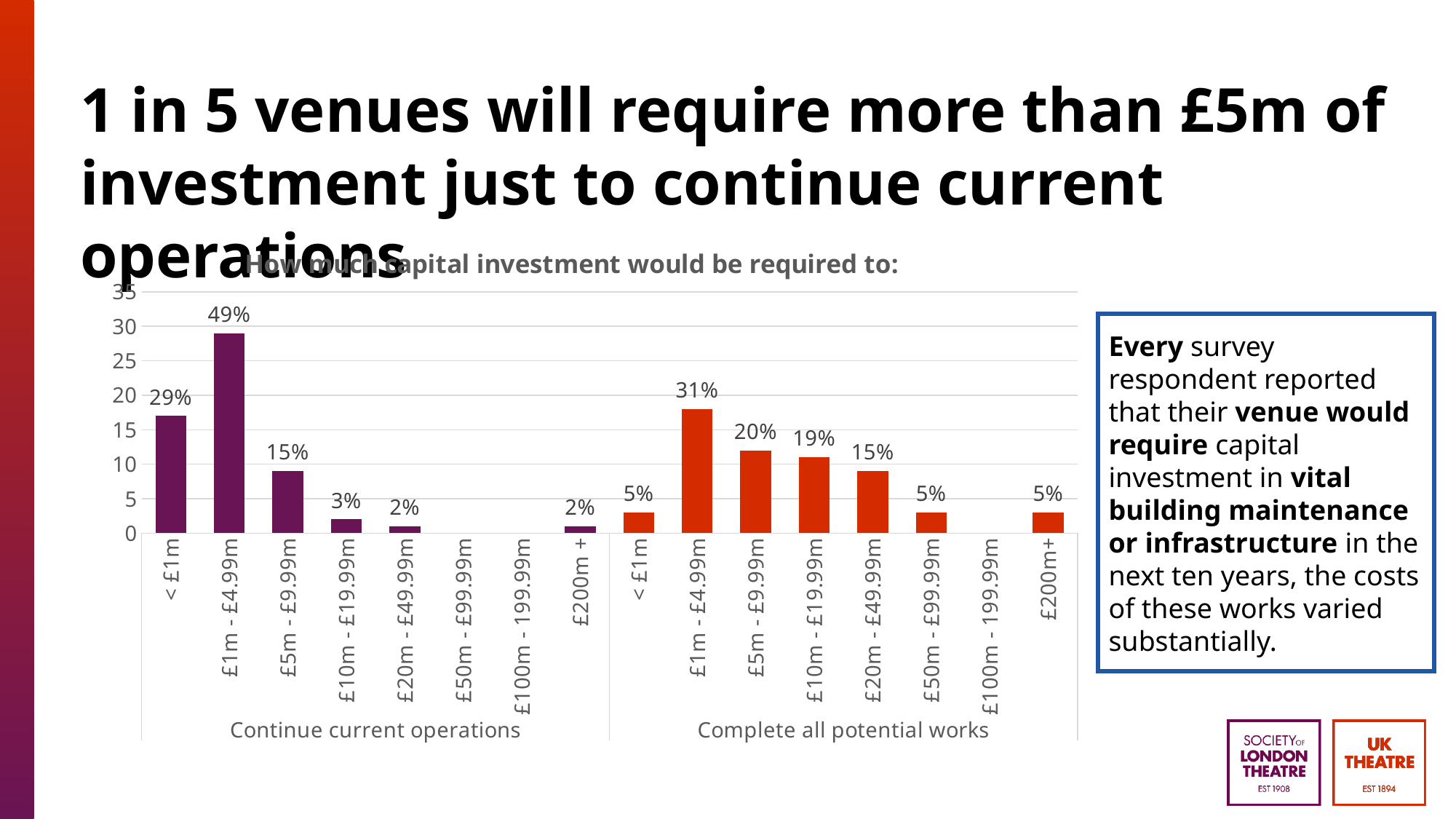
What percentage label is shown for the £200m+ bar under Complete all potential works? 5% What percentage label is shown for the £5m - £9.99m bar under Complete all potential works? 20% Which investment band has the highest bar under Continue current operations? £1m - £4.99m What kind of chart is shown on the slide? Bar chart How many investment band categories are listed on the x axis for each group? 8 What percentage label is shown for the £1m - £4.99m bar under Continue current operations? 49% What colour are the bars for Complete all potential works? Orange-red What percentage label is shown for the < £1m bar under Continue current operations? 29% Is the £1m - £4.99m bar under Continue current operations greater or less than 25 on the y axis? greater Which investment band has the highest bar under Complete all potential works? £1m - £4.99m What is the difference in percentage points between the £1m - £4.99m bars for Continue current operations (49%) and Complete all potential works (31%)? 18 Which is larger: the £10m - £19.99m bar under Continue current operations or under Complete all potential works? Complete all potential works